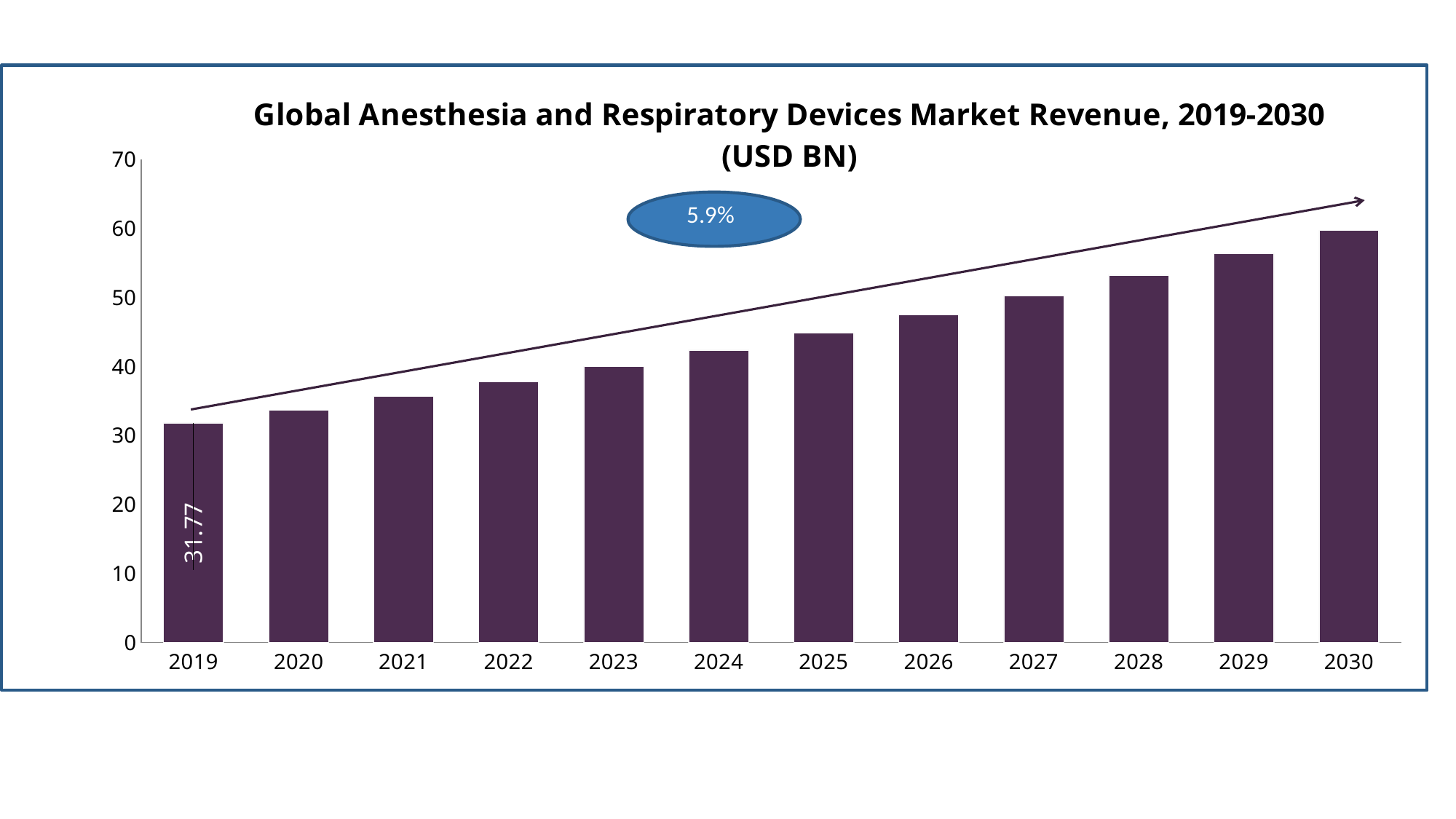
Is the value for 2021 greater or less than 40? less What percentage is shown in the blue oval on the chart? 5.9% Do the values rise or fall from 2019 to 2030? rise What kind of chart is this? bar chart Is the value for 2030 greater or less than 50? greater Which year has the lowest value? 2019 Which is larger, the value for 2025 or the value for 2020? 2025 How many years are shown on the x axis? 12 Is the value for 2027 greater or less than 40? greater Which year has the highest value? 2030 What is the value for 2019? 31.77